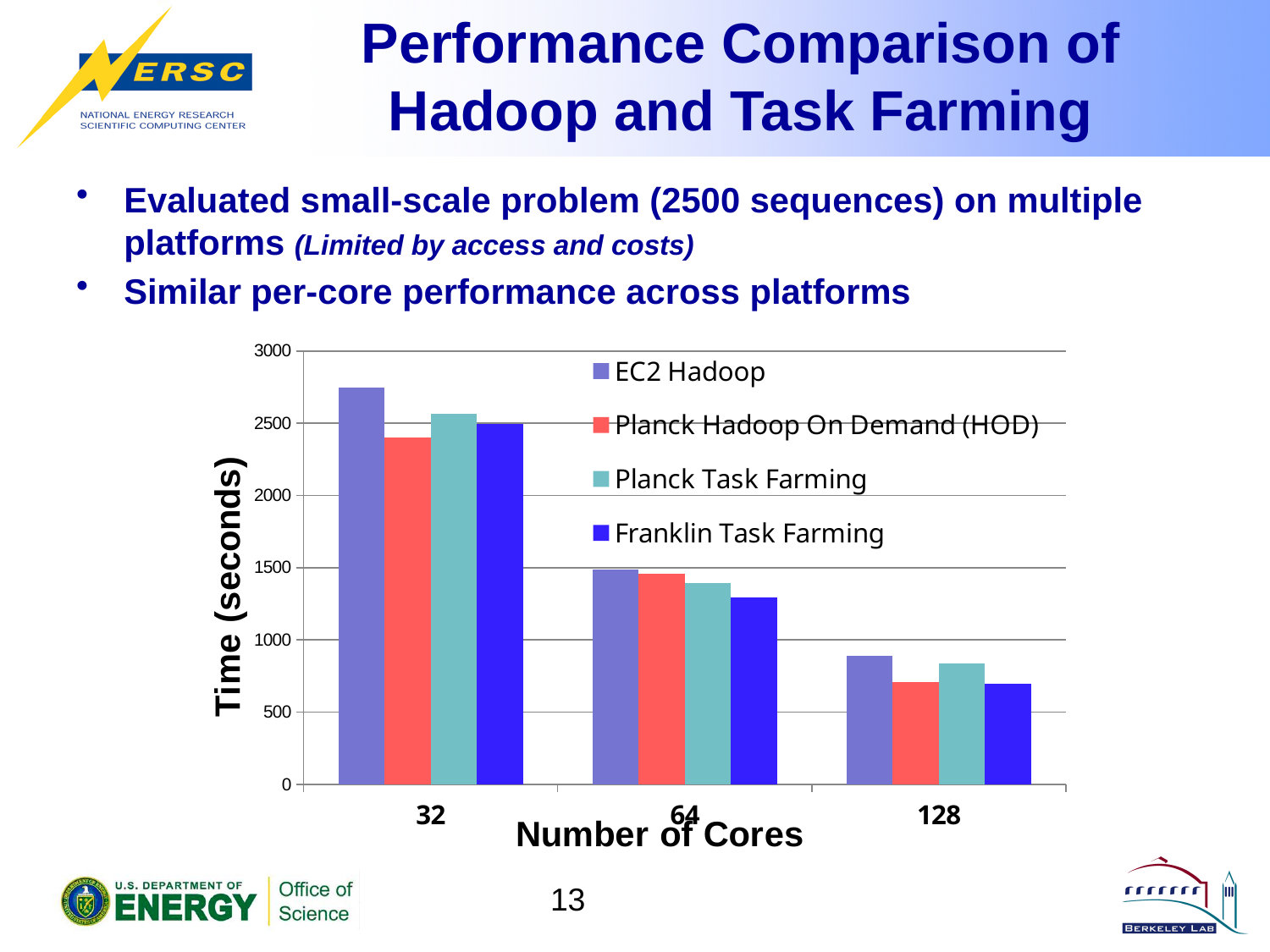
Which series has the highest time at 32 cores? EC2 Hadoop What kind of chart is shown on the slide? bar chart How many core-count categories are shown on the x axis? 3 Is the value for EC2 Hadoop at 32 cores greater or less than 2500? greater Which series has the lowest time at 64 cores? Franklin Task Farming Is the value for Planck Hadoop On Demand (HOD) at 32 cores greater or less than 2500? less How many series does the legend list? 4 Which series has the lowest time at 32 cores? Planck Hadoop On Demand (HOD) Is the value for Franklin Task Farming at 64 cores greater or less than 1000? greater Does the time for EC2 Hadoop rise or fall as the number of cores increases? fall What is the label of the vertical axis? Time (seconds)